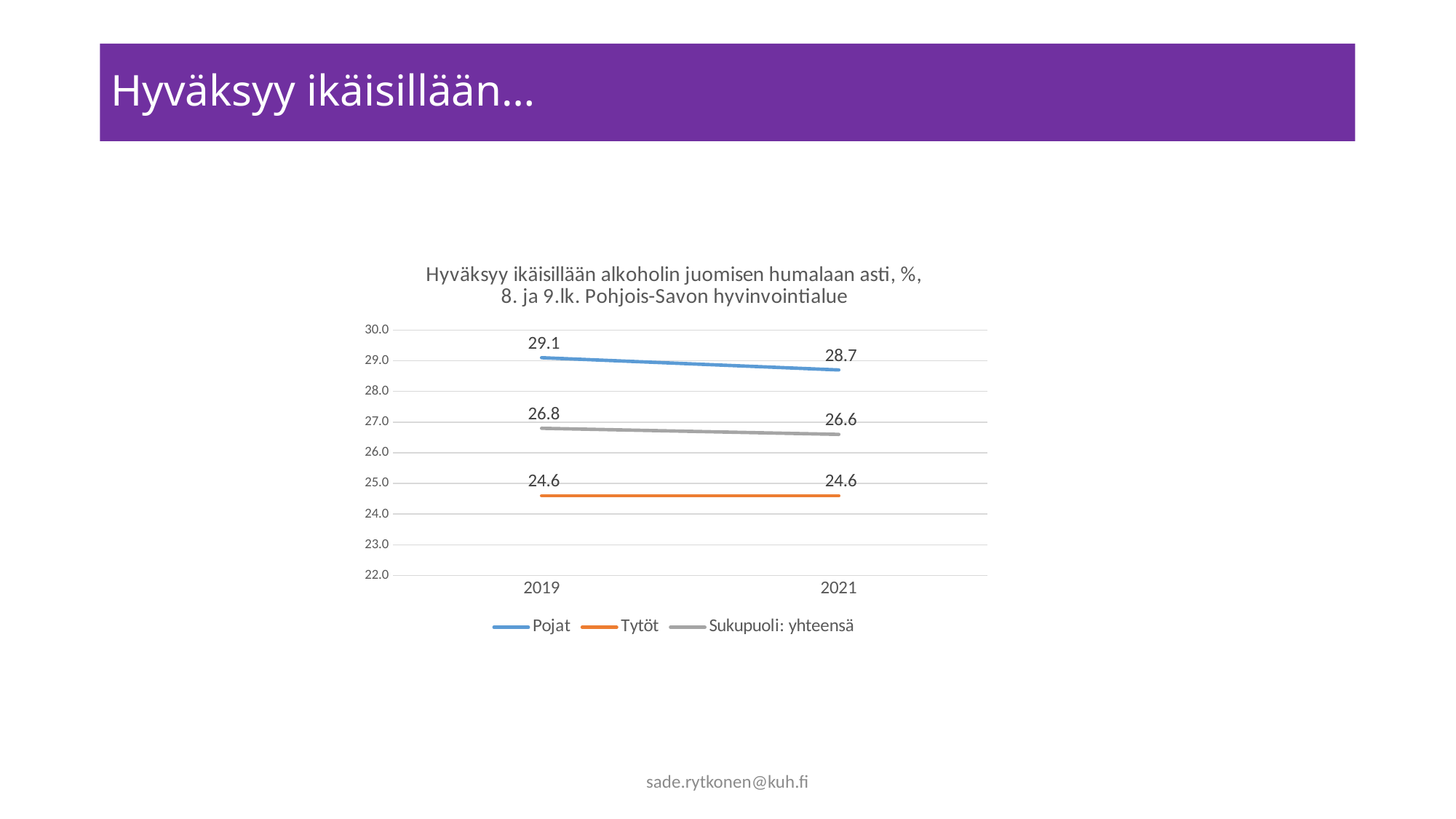
What is the value for Sukupuoli: yhteensä in 2019? 26.8 Which is larger in 2021, the value for Pojat or the value for Sukupuoli: yhteensä? Pojat Is the value for Tytöt in 2019 greater or less than 25.0? less What kind of chart is shown on the slide? line chart Does the value for Sukupuoli: yhteensä rise or fall from 2019 to 2021? fall Which series has the lowest value in 2019? Tytöt Which series has the highest value in 2021? Pojat What is the value for Pojat in 2019? 29.1 What is the difference between the Pojat values in 2019 and 2021? 0.4 How many years are shown on the x axis? 2 What is the value for Tytöt in 2021? 24.6 How many series does the legend list? 3